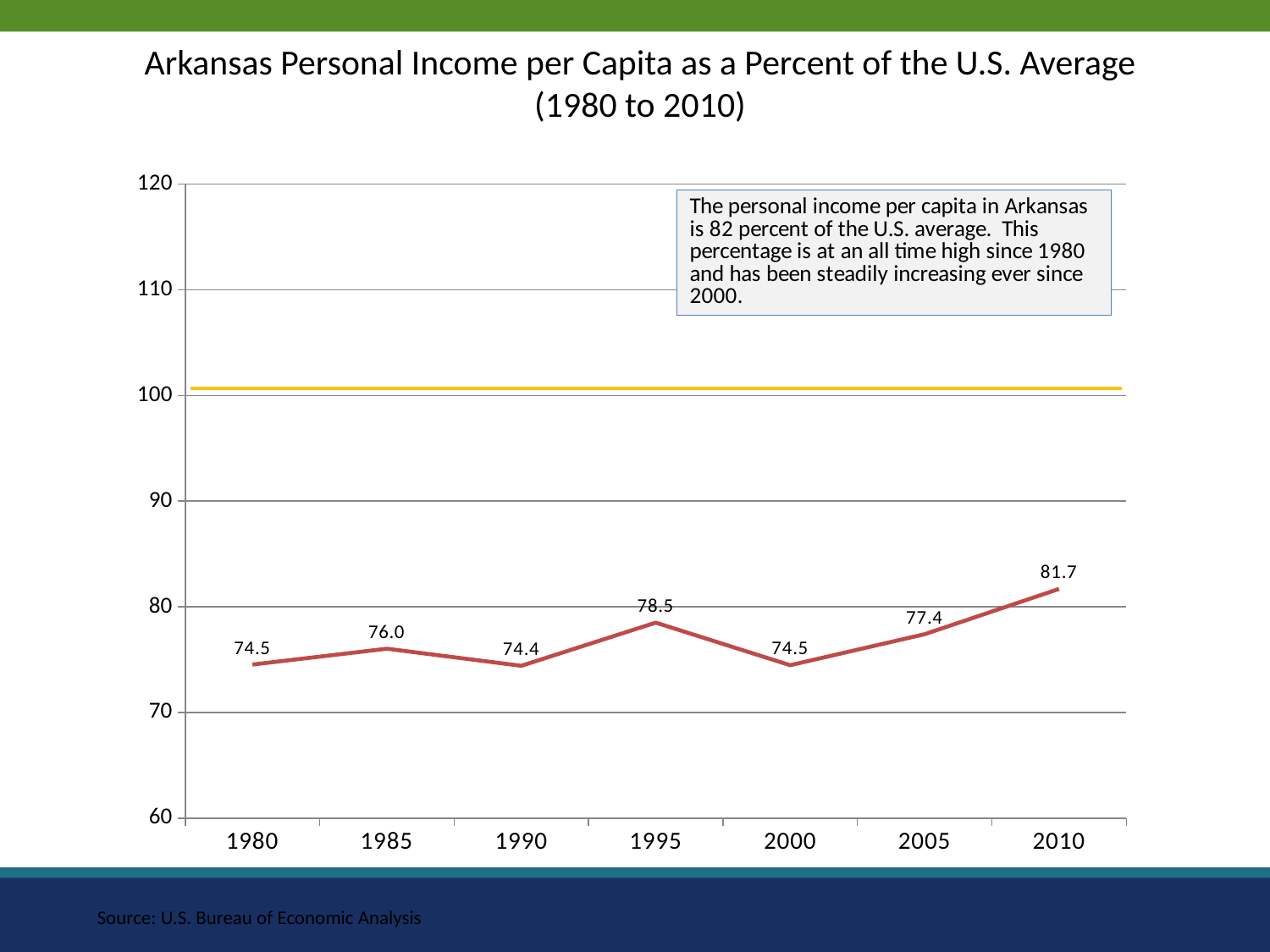
How many years are plotted on the x axis? 7 What is the value for 2005? 77.4 What is the value for 2010? 81.7 Which is larger, the value for 1995 or the value for 2005? 1995 Do the values rise or fall from 2000 to 2010? rise What kind of chart is shown? line chart What is the value for 1995? 78.5 Which year has the lowest value? 1990 What is the value for 1980? 74.5 Is the value for 2010 greater or less than 80? greater Which year has the highest value? 2010 What is the difference between the values for 2010 and 2000? 7.2